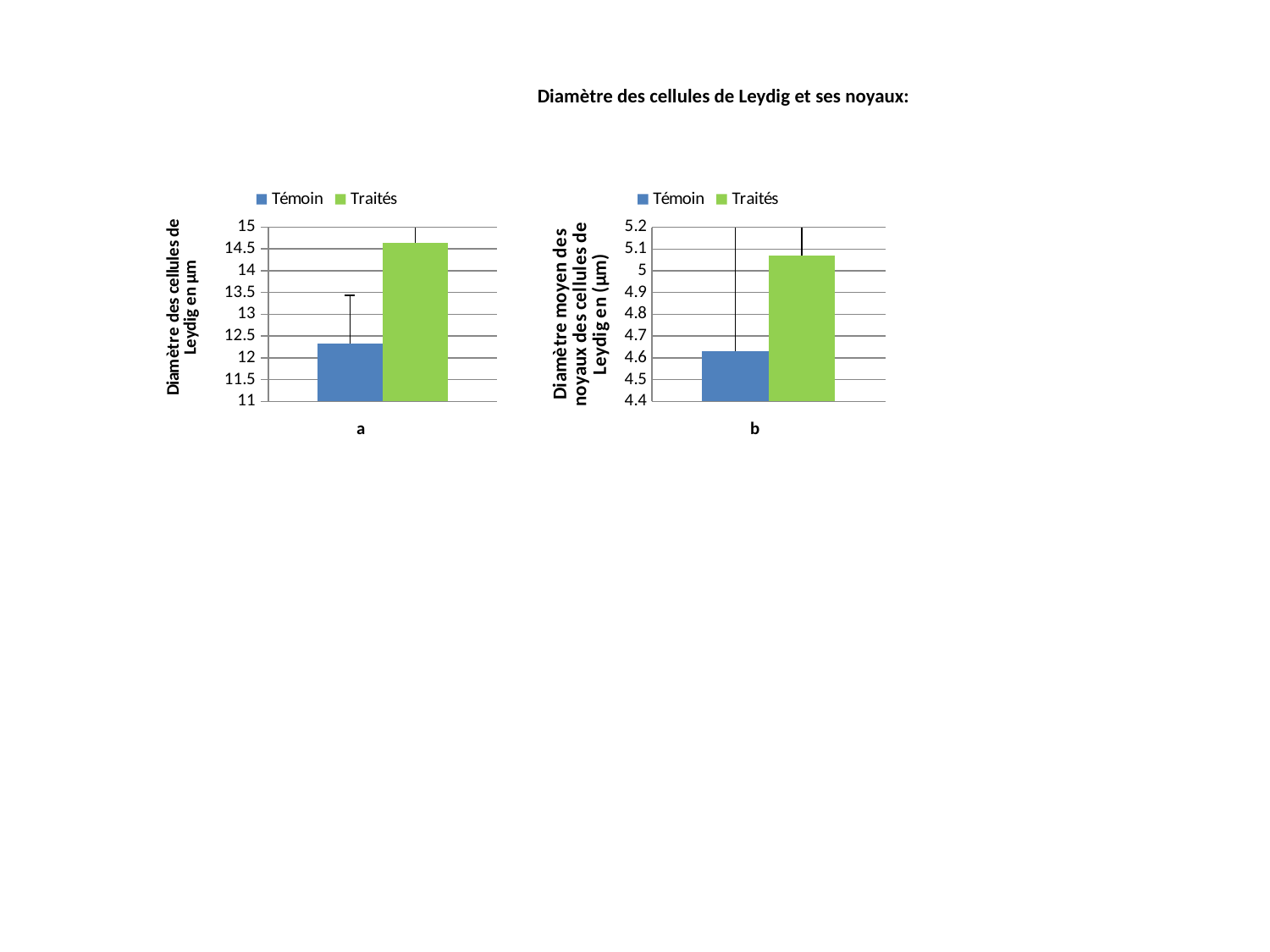
In the left chart (a), is the value for Témoin greater or less than 13? less What are the two legend entries of the left chart (a)? Témoin and Traités In the right chart (b), is the value for Traités greater or less than 5? greater How many series does the legend of the right chart (b) list? 2 How many bars are plotted in the right chart (b)? 2 In the left chart (a), which series has the higher value, Témoin or Traités? Traités In the left chart (a), is the value for Traités greater or less than 14? greater What kind of chart is the left chart (a)? bar chart In the right chart (b), which series has the lower value? Témoin In the right chart (b), which series has the highest value? Traités What is the y-axis title of the left chart (a)? Diamètre des cellules de Leydig en µm